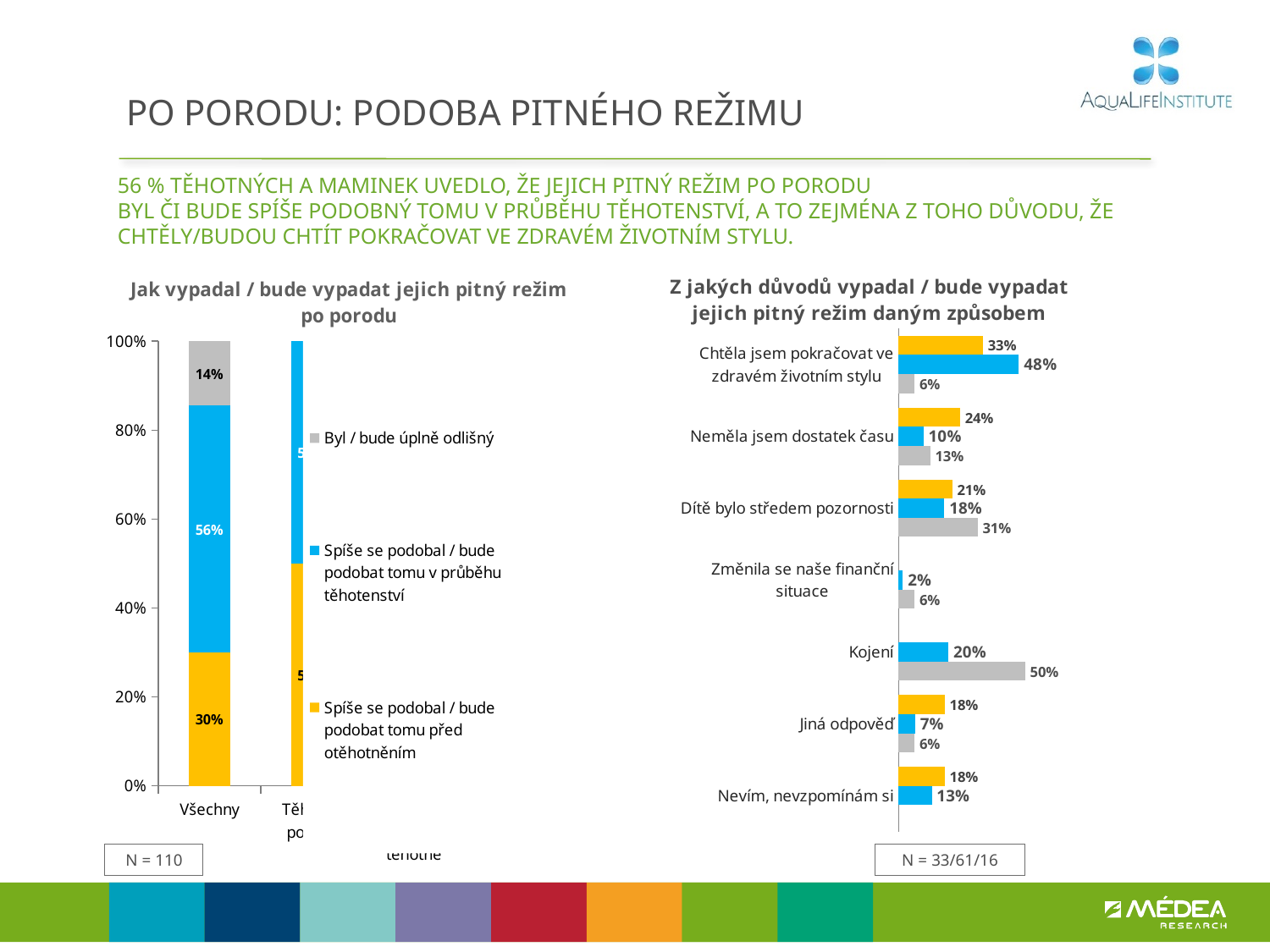
In the left chart 'Jak vypadal / bude vypadat jejich pitný režim po porodu', what is the value of the 'Spíše se podobal / bude podobat tomu v průběhu těhotenství' segment for 'Všechny'? 56% In the right chart 'Z jakých důvodů vypadal / bude vypadat jejich pitný režim daným způsobem', what is the value of the grey bar for 'Kojení'? 50% In the right chart 'Z jakých důvodů vypadal / bude vypadat jejich pitný režim daným způsobem', what is the smallest labelled value and which category does it belong to? 2%, Změnila se naše finanční situace In the left chart 'Jak vypadal / bude vypadat jejich pitný režim po porodu', which legend category has the largest segment in the 'Všechny' bar? Spíše se podobal / bude podobat tomu v průběhu těhotenství In the right chart 'Z jakých důvodů vypadal / bude vypadat jejich pitný režim daným způsobem', for 'Neměla jsem dostatek času', is the yellow bar or the grey bar larger? The yellow bar (24%) In the right chart 'Z jakých důvodů vypadal / bude vypadat jejich pitný režim daným způsobem', what is the value of the blue bar for 'Chtěla jsem pokračovat ve zdravém životním stylu'? 48% In the left chart 'Jak vypadal / bude vypadat jejich pitný režim po porodu', what is the total of the three segments in the 'Všechny' bar? 100% How many reason categories are listed in the right chart 'Z jakých důvodů vypadal / bude vypadat jejich pitný režim daným způsobem'? 7 What kind of chart is the left chart 'Jak vypadal / bude vypadat jejich pitný režim po porodu'? Stacked bar chart In the left chart 'Jak vypadal / bude vypadat jejich pitný režim po porodu', what is the value of the 'Byl / bude úplně odlišný' segment for 'Všechny'? 14% How many series does the legend of the left chart 'Jak vypadal / bude vypadat jejich pitný režim po porodu' list? 3 In the right chart 'Z jakých důvodů vypadal / bude vypadat jejich pitný režim daným způsobem', what is the difference between the grey bar and the blue bar for 'Dítě bylo středem pozornosti'? 13 percentage points